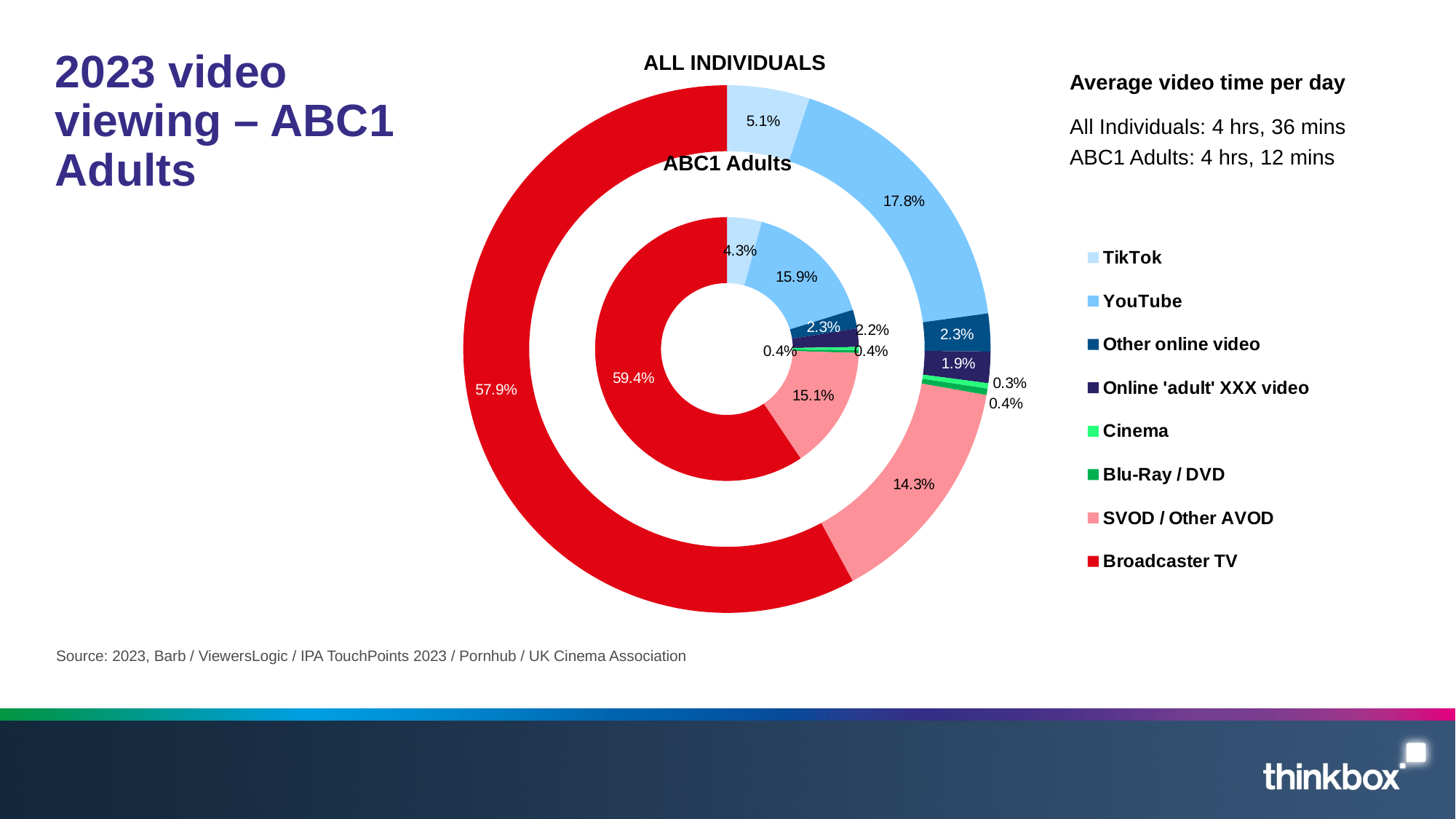
In the ABC1 Adults ring, what is the share for SVOD / Other AVOD? 15.1% In the ABC1 Adults ring, what is the share for TikTok? 4.3% In the ALL INDIVIDUALS ring, what share of video viewing is Broadcaster TV? 57.9% What is the difference between the YouTube share for ALL INDIVIDUALS and for ABC1 Adults? 1.9 percentage points Which is larger: the SVOD / Other AVOD share for ALL INDIVIDUALS or for ABC1 Adults? ABC1 Adults According to the text on the slide, what is the average video time per day for ABC1 Adults? 4 hrs, 12 mins Which category has the largest share in the ALL INDIVIDUALS ring? Broadcaster TV Which category has the smallest share in the ALL INDIVIDUALS ring? Cinema In the ALL INDIVIDUALS ring, what is the share for YouTube? 17.8% What type of chart is shown on the slide? Doughnut chart In the ABC1 Adults ring, what share of video viewing is Broadcaster TV? 59.4% How many categories does the legend list? 8